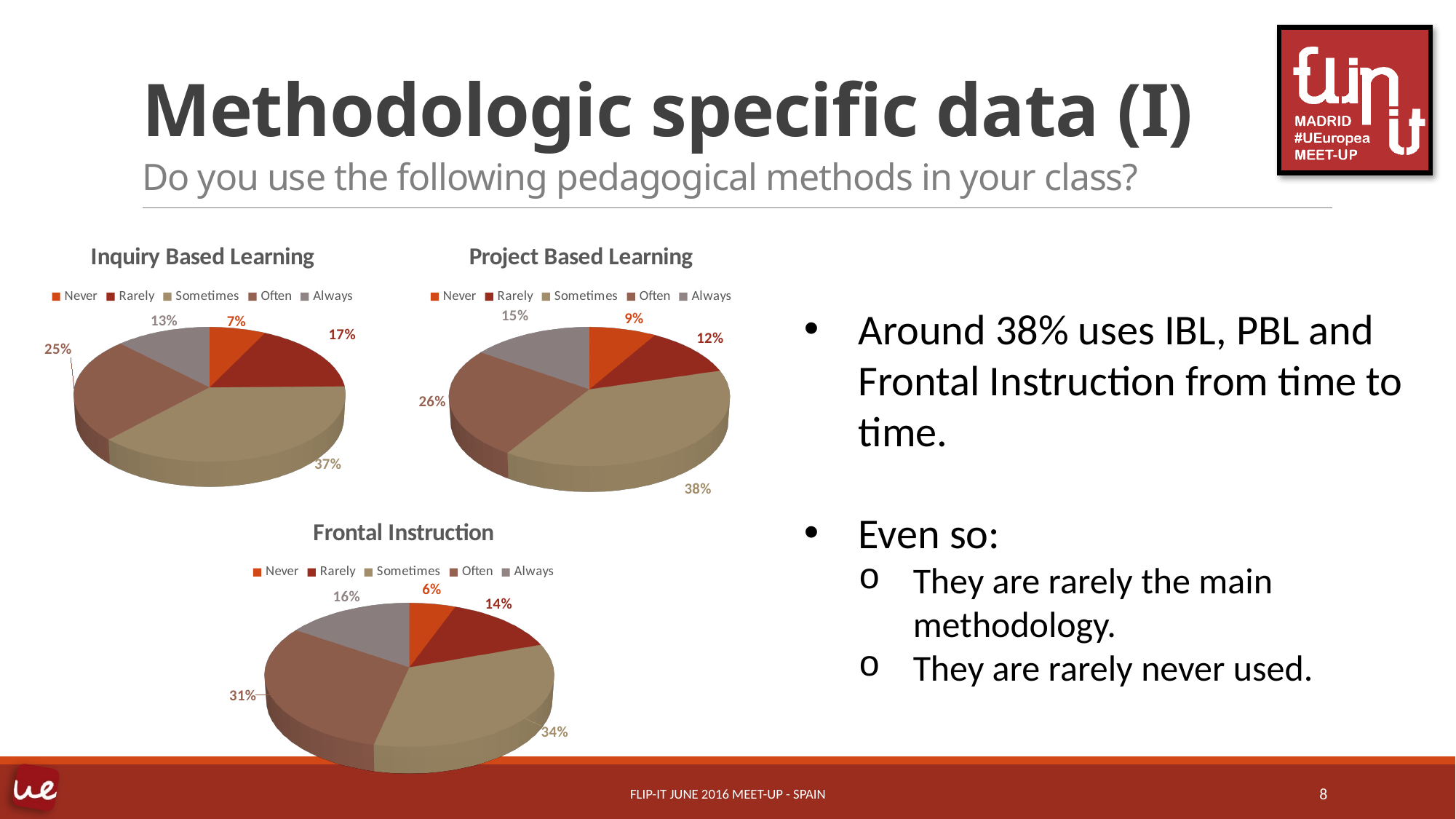
In the Project Based Learning chart, which category has the largest share? Sometimes What type of chart is used for Inquiry Based Learning? Pie chart In the Inquiry Based Learning chart, what percentage of respondents answered "Sometimes"? 37% In the Frontal Instruction chart, what percentage of respondents answered "Always"? 16% In the Project Based Learning chart, what is the difference between the "Always" and "Never" shares? 6% How many pie charts are shown on the slide? 3 In the Frontal Instruction chart, which is larger, the "Never" share or the "Rarely" share? Rarely In the Inquiry Based Learning chart, which category has the smallest share? Never In the Project Based Learning chart, what percentage of respondents answered "Often"? 26% In the Inquiry Based Learning chart, which is larger, the "Rarely" share or the "Always" share? Rarely How many series does the legend of the Frontal Instruction chart list? 5 In the Frontal Instruction chart, what is the difference between the "Sometimes" and "Often" shares? 3%